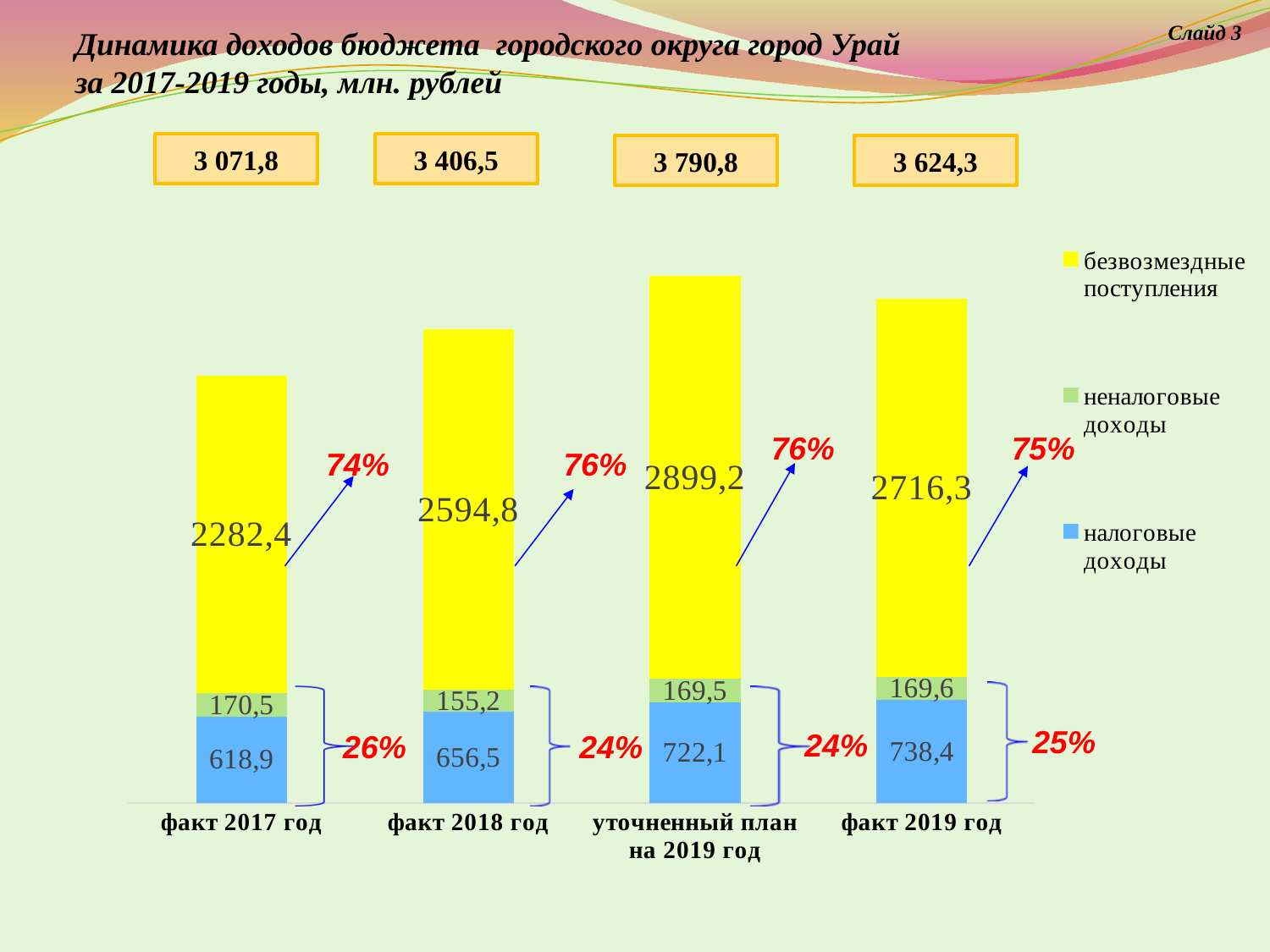
Which category has the highest value of безвозмездные поступления? уточненный план на 2019 год Which is larger: неналоговые доходы for факт 2018 год or for факт 2019 год? факт 2019 год How many series does the legend list? 3 What is the value of безвозмездные поступления for факт 2018 год? 2594,8 What is the total of the stacked bar for факт 2019 год? 3 624,3 Which series is shown in yellow in the legend? безвозмездные поступления What is the value of налоговые доходы for уточненный план на 2019 год? 722,1 Which category has the lowest value of налоговые доходы? факт 2017 год How many categories are shown along the x axis? 4 What type of chart is shown on the slide? stacked bar chart What is the difference between налоговые доходы for факт 2019 год and факт 2018 год? 81,9 What is the value of неналоговые доходы for факт 2017 год? 170,5